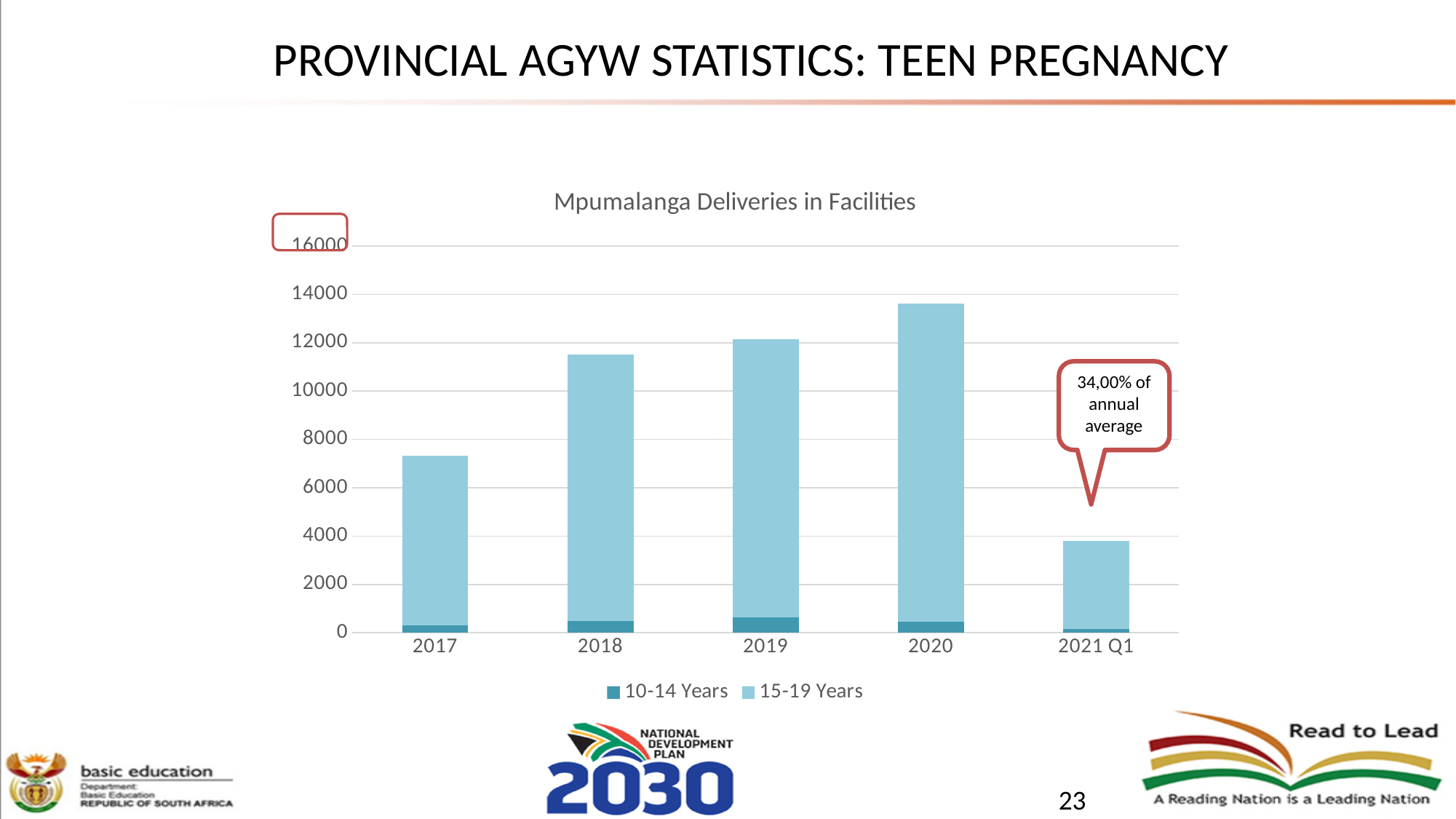
Which category has the tallest stacked bar? 2020 How many series does the legend list? 2 Do the total deliveries rise or fall from 2017 to 2020? rise Which category has the shortest stacked bar? 2021 Q1 Which has a taller stacked bar, 2018 or 2019? 2019 Is the total bar for 2020 greater or less than 12000? greater What does the callout next to the 2021 Q1 bar say? 34,00% of annual average Is the total bar for 2017 greater or less than 8000? less What kind of chart is shown on the slide? Stacked bar chart What is the title of the chart? Mpumalanga Deliveries in Facilities How many categories are shown on the x axis of the chart? 5